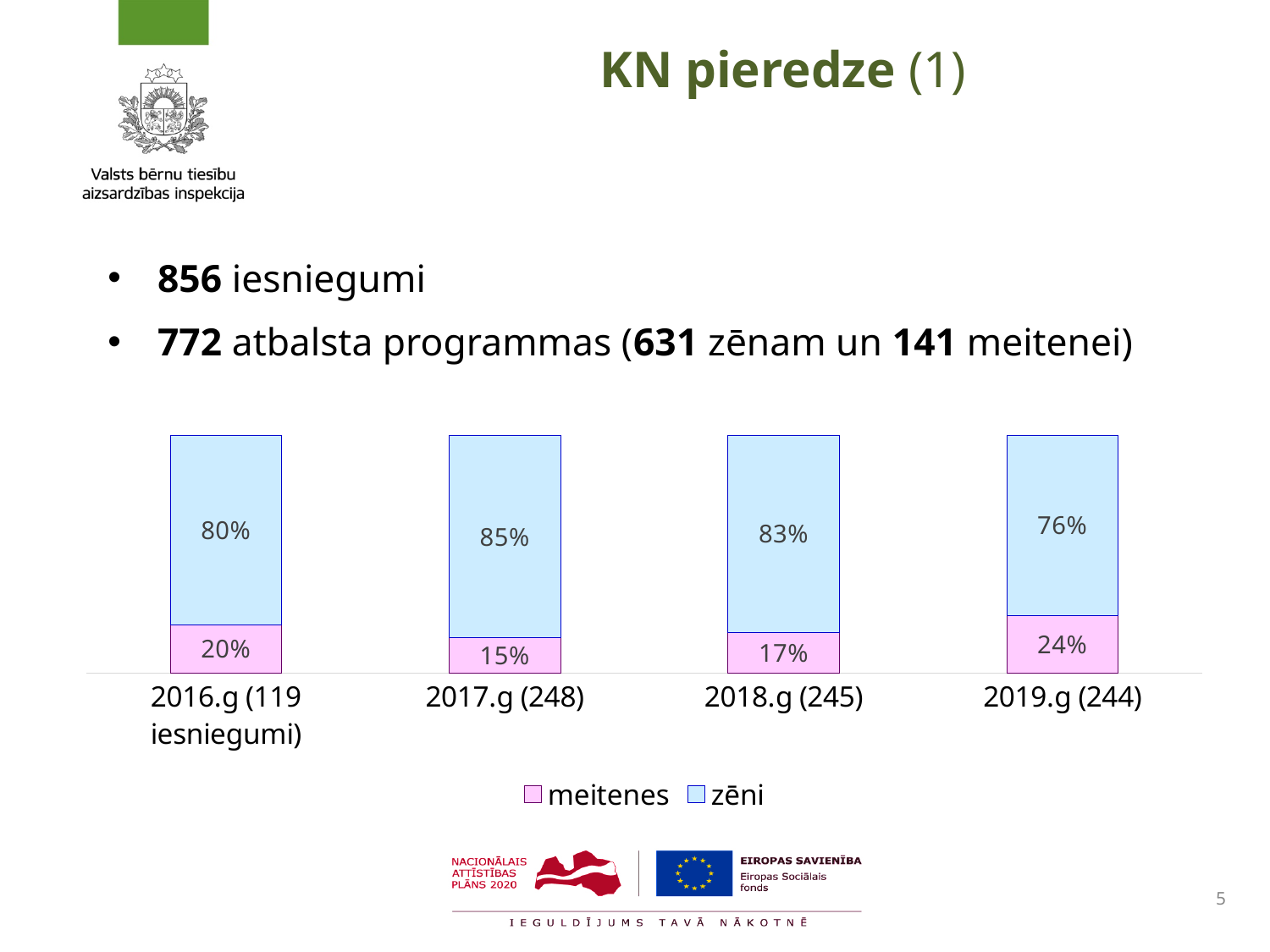
In which year is the zēni share the highest? 2017.g (248) In which year is the meitenes share the lowest? 2017.g (248) What is the zēni value for 2018.g (245)? 83% How many year categories does the chart show? 4 What is the meitenes value for 2016.g (119 iesniegumi)? 20% Which is larger, the meitenes share in 2018.g (245) or in 2019.g (244)? 2019.g (244) How many series does the legend list? 2 What type of chart is shown on the slide? Stacked bar chart In which year is the meitenes share the highest? 2019.g (244) What is the difference between the zēni and meitenes shares in 2016.g (119 iesniegumi)? 60% What percentage of the 2017.g (248) bar is zēni? 85% What is the meitenes share shown for 2019.g (244)? 24%